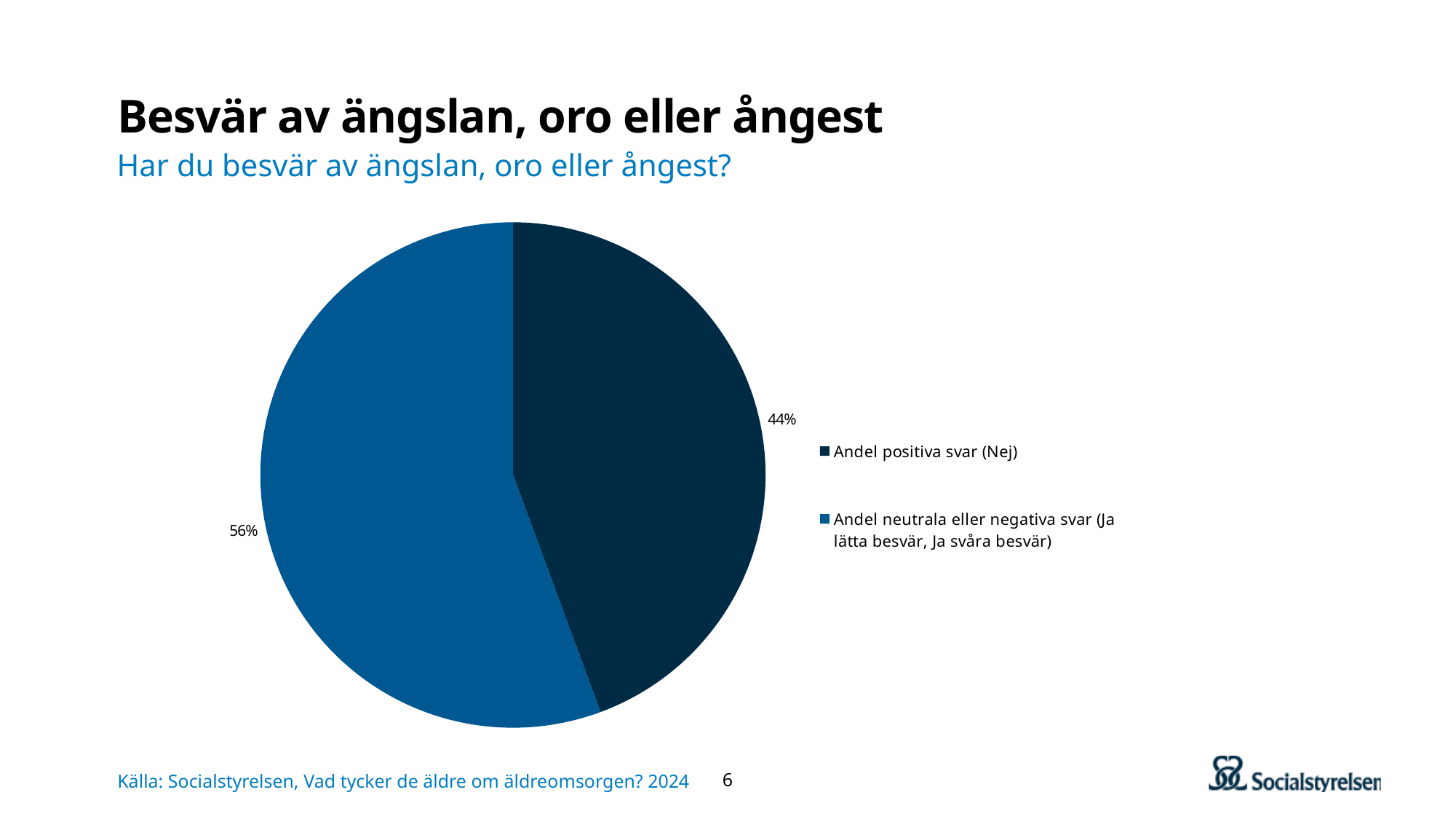
How many slices does the pie chart have? 2 Is the share for "Andel positiva svar (Nej)" greater or less than 50%? less What share of the pie is labelled "Andel positiva svar (Nej)"? 44% What is the title of the slide containing the pie chart? Besvär av ängslan, oro eller ångest What question is the pie chart based on, as shown in the subtitle? Har du besvär av ängslan, oro eller ångest? Which is larger: the share of positive answers (Nej) or the share of neutral or negative answers? Andel neutrala eller negativa svar (Ja lätta besvär, Ja svåra besvär) What is the difference in percentage points between the two slices of the pie? 12 percentage points What kind of chart is shown on the slide? pie chart What share of the pie is labelled "Andel neutrala eller negativa svar (Ja lätta besvär, Ja svåra besvär)"? 56% How many entries does the legend list? 2 Which slice of the pie is the smallest? Andel positiva svar (Nej) Which slice of the pie is the largest? Andel neutrala eller negativa svar (Ja lätta besvär, Ja svåra besvär)